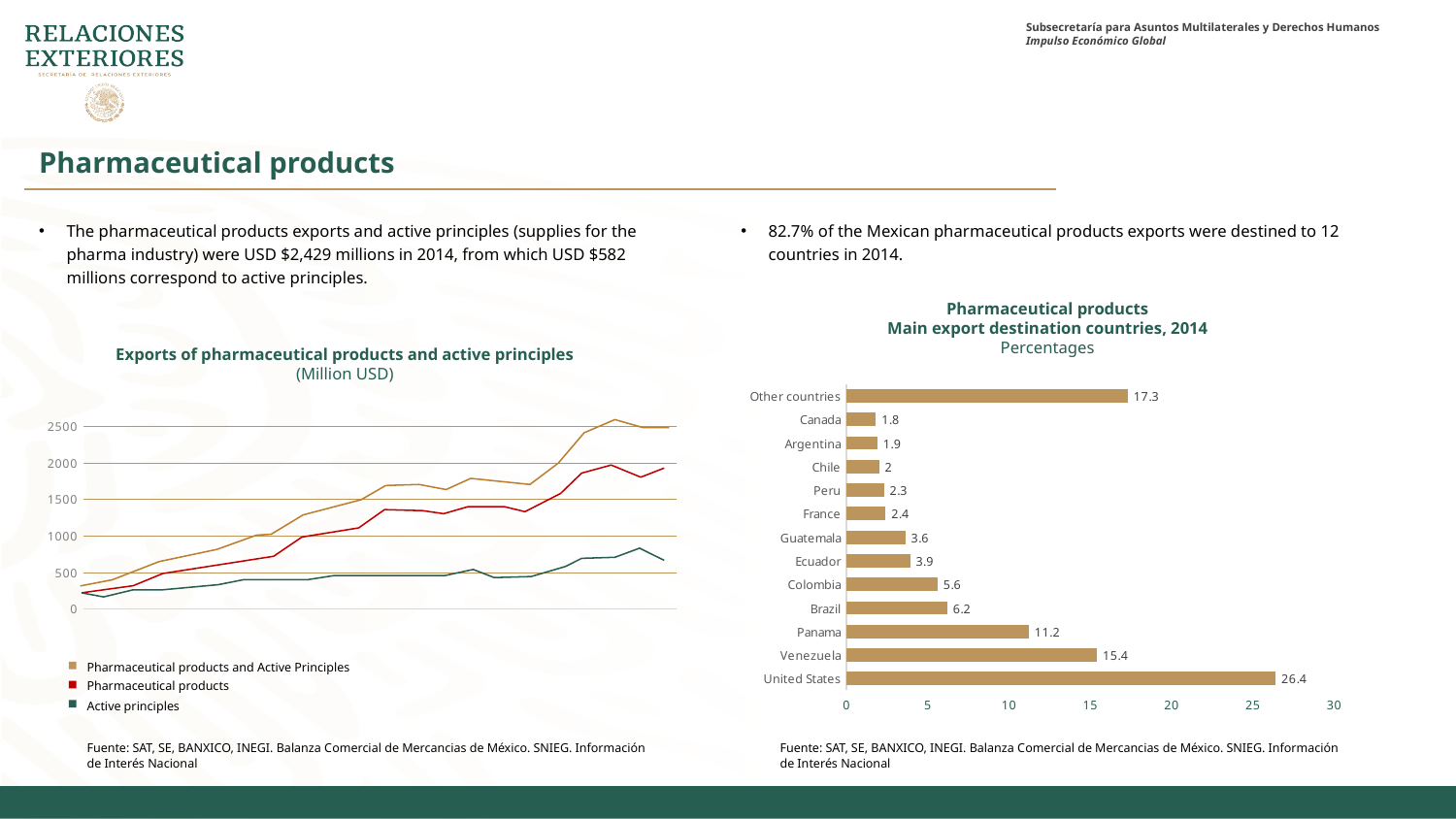
In the 'Main export destination countries, 2014' chart, which named country has the lowest value? Canada In the 'Main export destination countries, 2014' chart, what is the value for Venezuela? 15.4 How many bars are shown in the 'Main export destination countries, 2014' chart? 13 How many series does the legend of the 'Exports of pharmaceutical products and active principles' chart list? 3 What kind of chart is the 'Exports of pharmaceutical products and active principles' chart? Line chart What kind of chart is the 'Main export destination countries, 2014' chart? Bar chart In the 'Main export destination countries, 2014' chart, what percentage of exports went to the United States? 26.4 In the 'Exports of pharmaceutical products and active principles' chart, do the values for 'Pharmaceutical products and Active Principles' generally rise or fall along the x axis? Rise In the 'Main export destination countries, 2014' chart, what is the difference between the values for Brazil and Colombia? 0.6 In the 'Main export destination countries, 2014' chart, which has a larger value, Guatemala or Ecuador? Ecuador In the 'Main export destination countries, 2014' chart, what is the value for Panama? 11.2 In the 'Main export destination countries, 2014' chart, which category has the highest value? United States